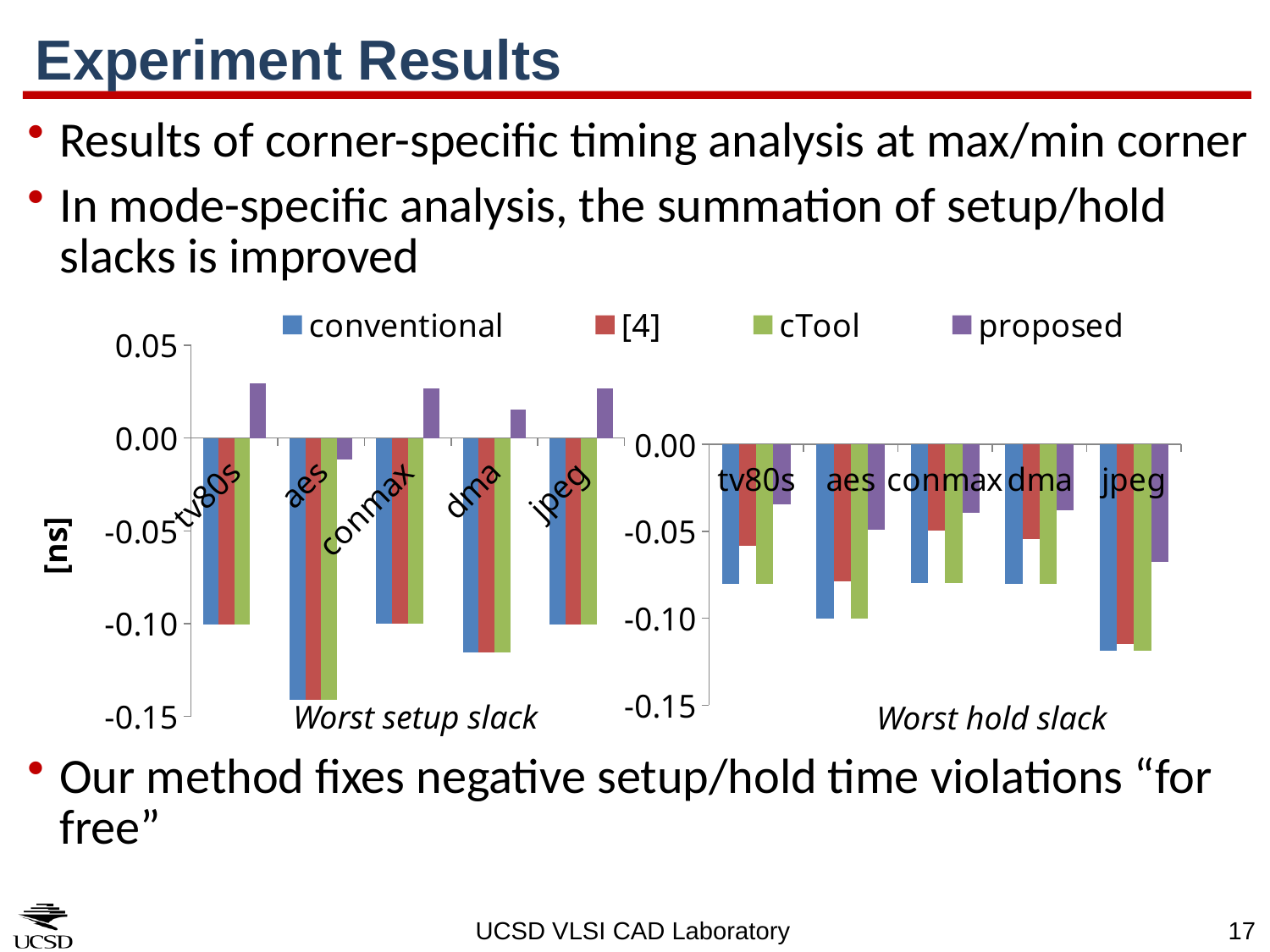
How many series does the legend list? 4 In the 'Worst setup slack' chart, is the conventional value for aes greater or less than -0.10? less In the 'Worst hold slack' chart, which series has the highest value for aes? proposed In the 'Worst setup slack' chart, which category has the lowest conventional value? aes How many categories are shown on the x axis of the 'Worst hold slack' chart? 5 In the 'Worst hold slack' chart, which category has the lowest proposed value? jpeg In the 'Worst setup slack' chart, is the proposed value for tv80s greater or less than 0.00? greater What kind of chart is the 'Worst setup slack' chart? bar chart In the 'Worst hold slack' chart, is the proposed value for conmax greater or less than -0.05? greater What is the label on the vertical axis of the left chart? [ns] In the 'Worst hold slack' chart, which is larger for tv80s, conventional or [4]? [4]